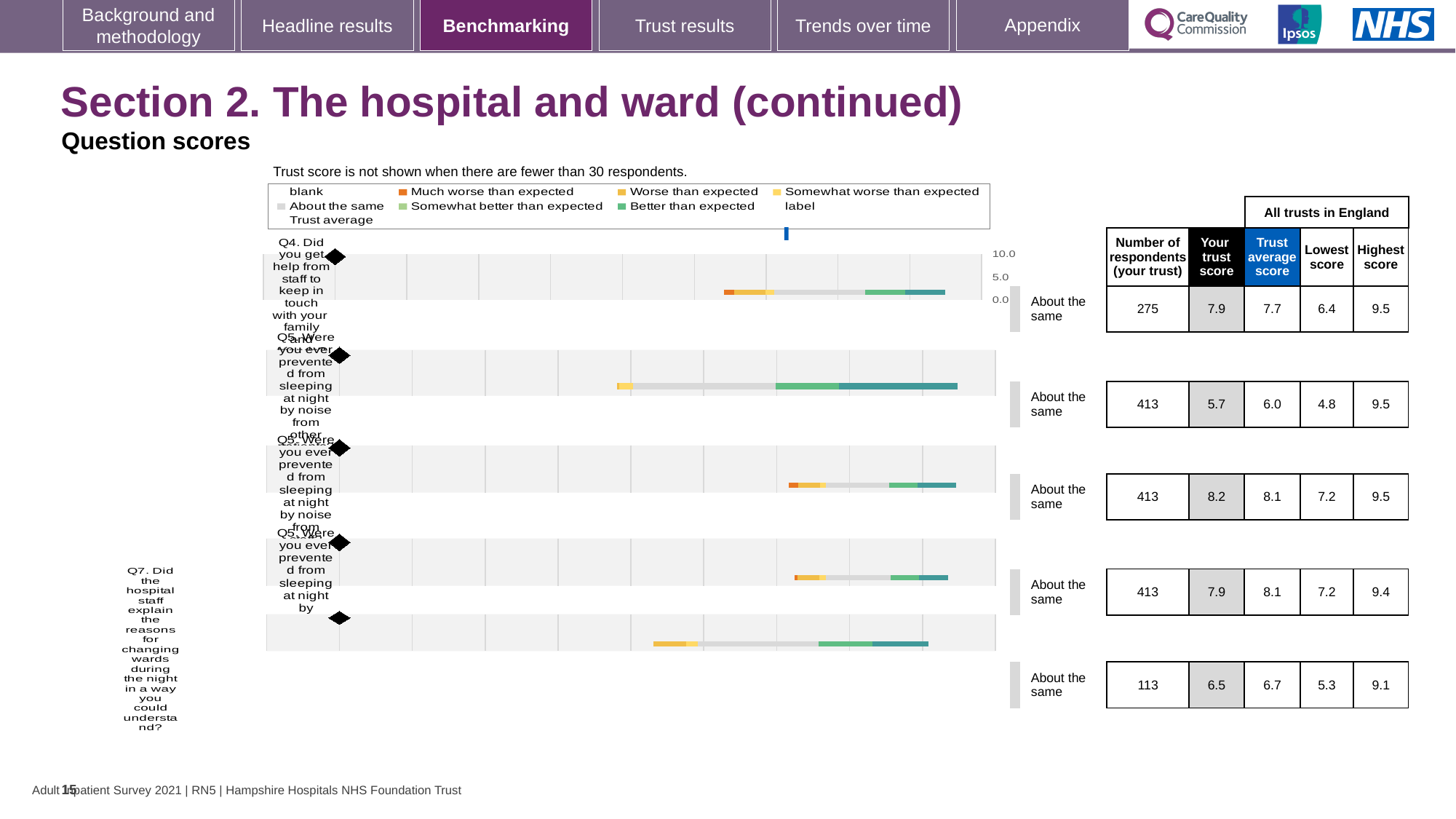
How many question rows (bars) are plotted in the chart? 5 In the table, how many respondents from your trust answered Q4 (help from staff to keep in touch with family)? 275 What is 'Your trust score' for Q4 in the table? 7.9 What is the 'Highest score' for Q7 (explaining reasons for changing wards during the night)? 9.1 What kind of chart is used to show the question scores on this slide? bar chart For Q7, what is the difference between the 'Trust average score' and 'Your trust score'? 0.2 For Q4, what is the difference between the 'Highest score' and the 'Lowest score'? 3.1 What is the 'Trust average score' for Q4? 7.7 For Q4, which is larger: 'Your trust score' or the 'Trust average score'? Your trust score How many respondents answered Q7 (explaining reasons for changing wards during the night)? 113 What is the lowest 'Your trust score' value shown in the table? 5.7